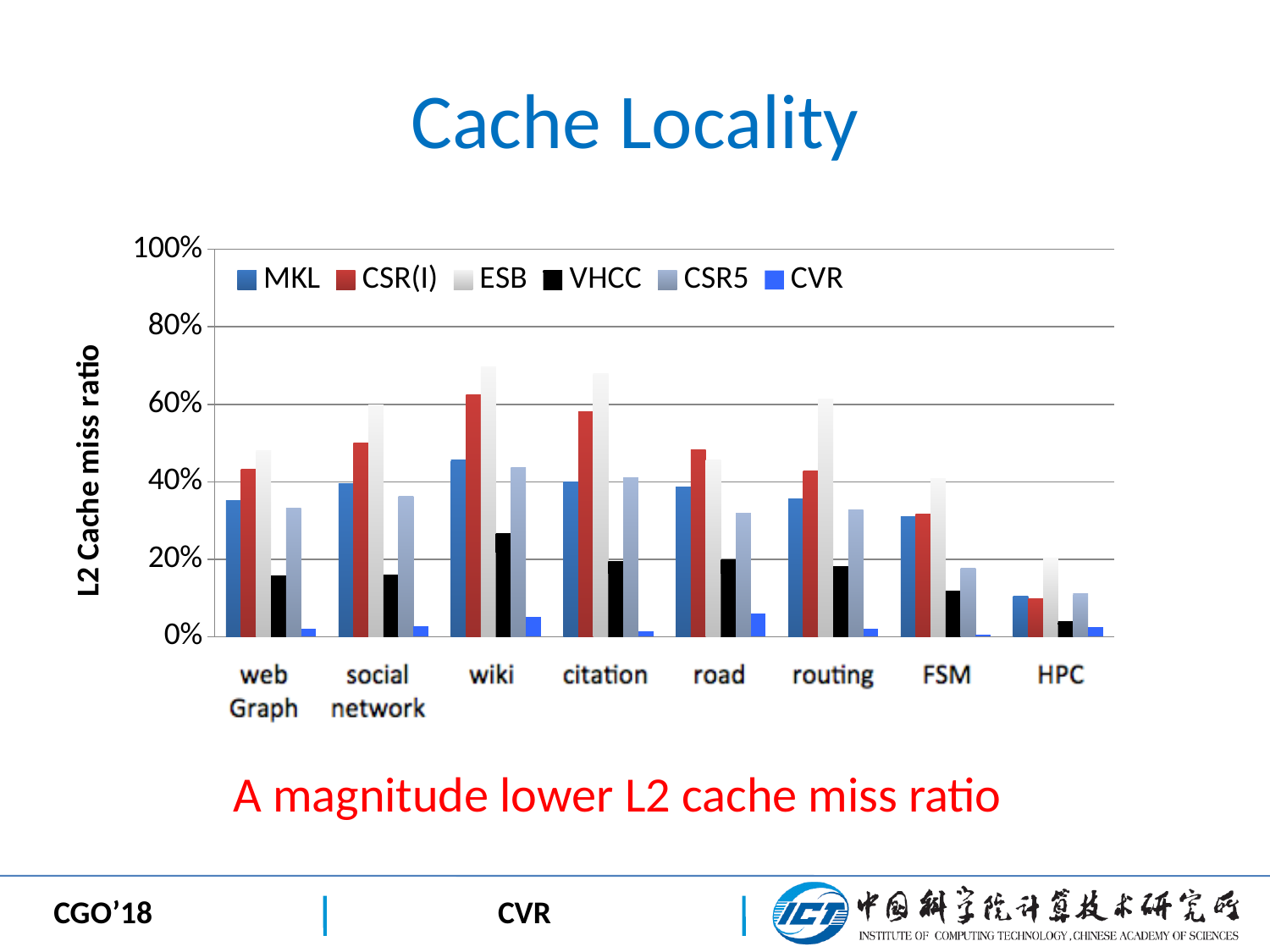
Is the MKL value for web Graph greater or less than 40%? less Is the ESB value for wiki greater or less than 60%? greater For road, which is larger, the CSR(I) value or the MKL value? CSR(I) How many series does the legend list? 6 What kind of chart is shown on the slide? bar chart How many categories are shown on the x axis? 8 What is the title of the chart's y axis? L2 Cache miss ratio Which series has the lowest L2 cache miss ratio for wiki? CVR For which category is the MKL value lowest? HPC Which series is shown in blue at the far right of the legend? CVR Is the CSR(I) value for social network greater or less than 40%? greater Which series has the highest L2 cache miss ratio for wiki? ESB